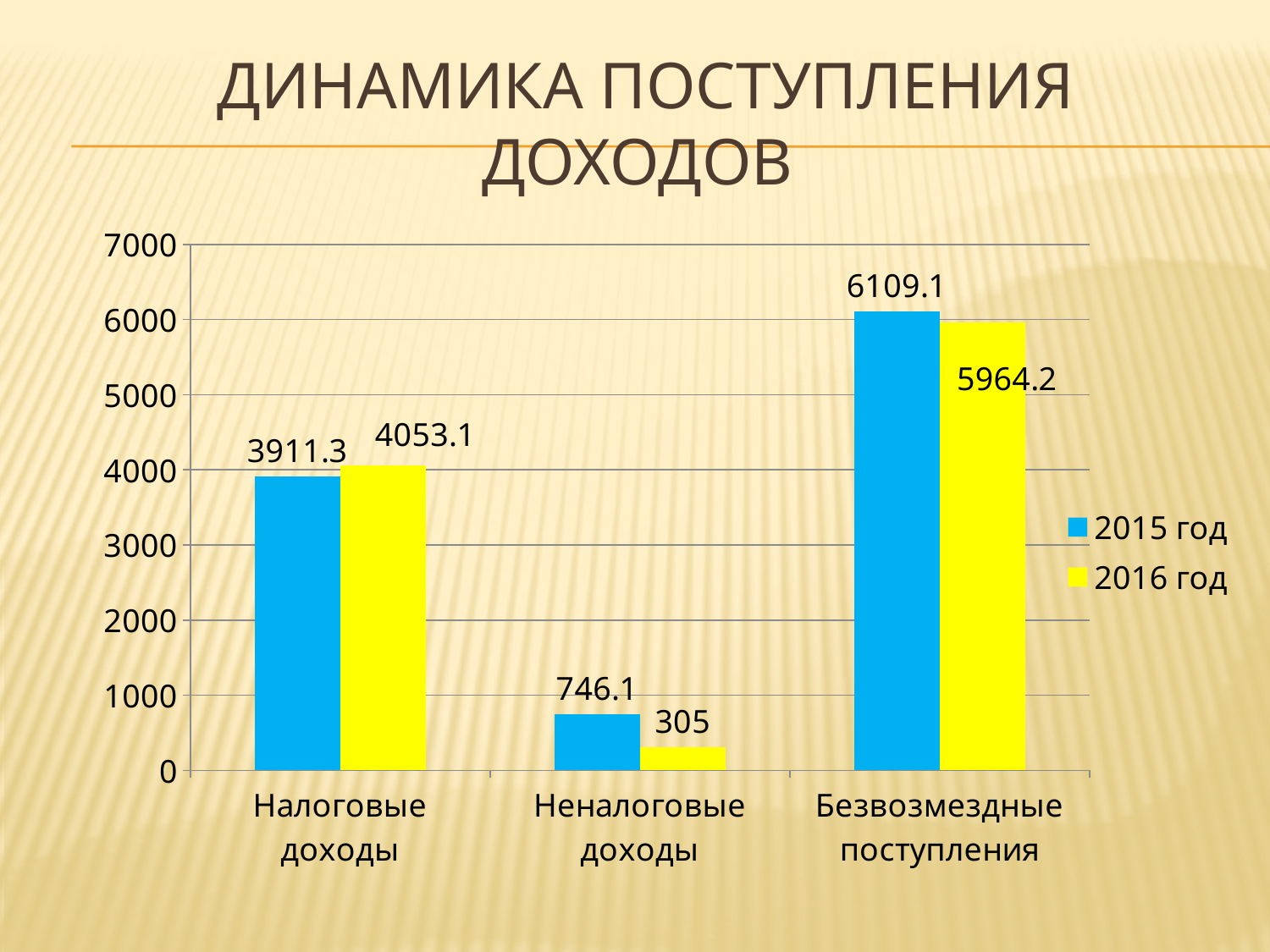
What kind of chart is shown on the slide? Bar chart What is the value for Налоговые доходы in the 2015 год series? 3911.3 Which category has the lowest value in the 2015 год series? Неналоговые доходы Which category has the highest value in the 2016 год series? Безвозмездные поступления What is the value for Неналоговые доходы in the 2016 год series? 305 Which is larger for Безвозмездные поступления: the 2015 год value or the 2016 год value? 2015 год What is the difference between the 2015 год and 2016 год values for Неналоговые доходы? 441.1 How many series does the legend list? 2 What is the title of the slide? ДИНАМИКА ПОСТУПЛЕНИЯ ДОХОДОВ What is the difference between the 2016 год and 2015 год values for Налоговые доходы? 141.8 What is the value for Безвозмездные поступления in the 2015 год series? 6109.1 How many categories are shown on the x axis? 3